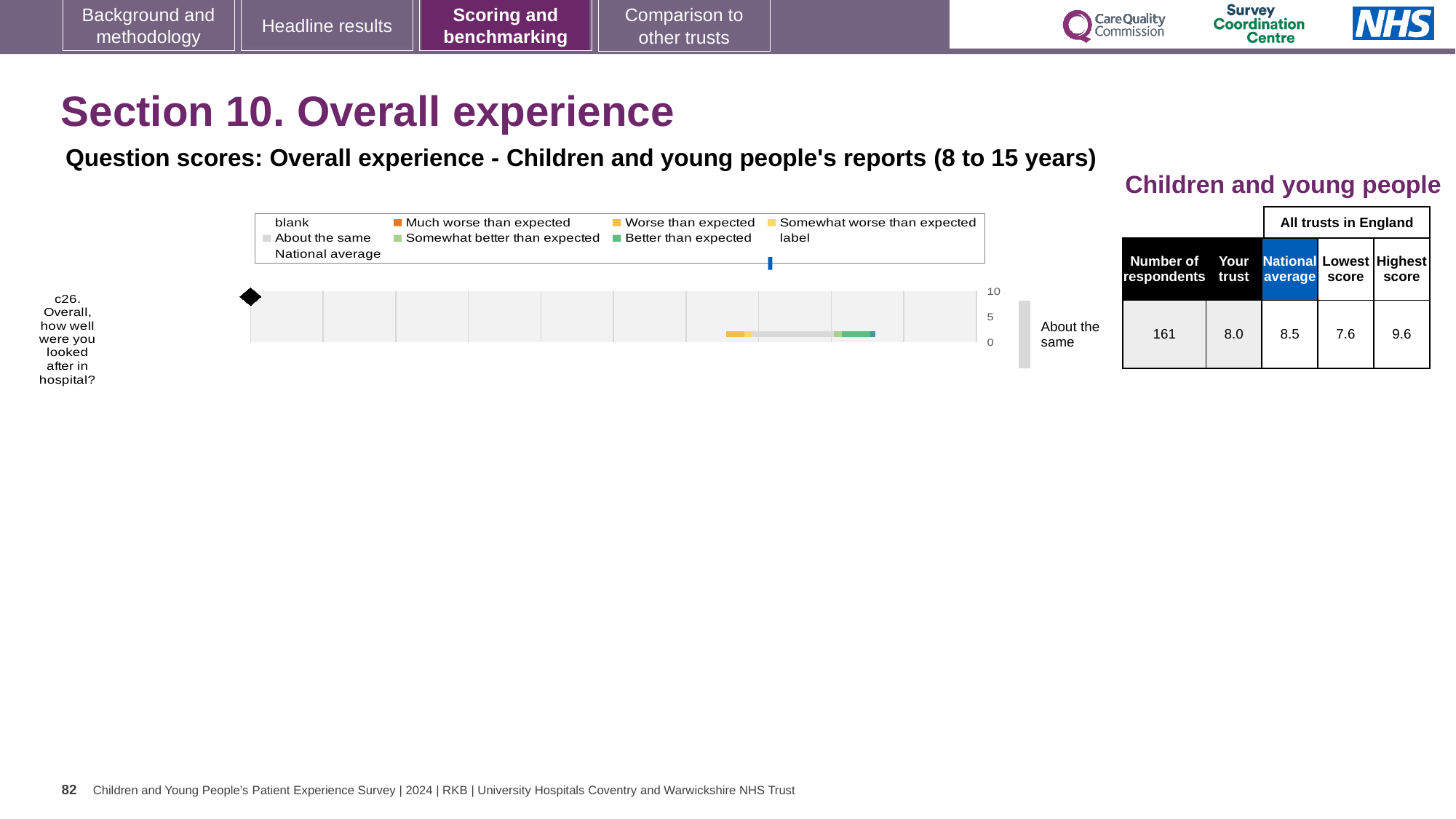
What is the 'Your trust' score for question c26 in the table? 8.0 What is the maximum value shown on the chart's axis? 10 What rating label is shown to the right of the chart for question c26? About the same How many questions (categories) are plotted in the chart? 1 What is the Lowest score among all trusts in England for question c26? 7.6 Which is larger for question c26: the Your trust score or the National average? National average What is the Highest score among all trusts in England for question c26? 9.6 How many respondents answered question c26? 161 Which question is plotted in the chart? c26. Overall, how well were you looked after in hospital? What kind of chart is shown for question c26? bar chart What is the difference between the Highest score and the Lowest score for question c26? 2.0 What is the National average score for question c26 in the table? 8.5